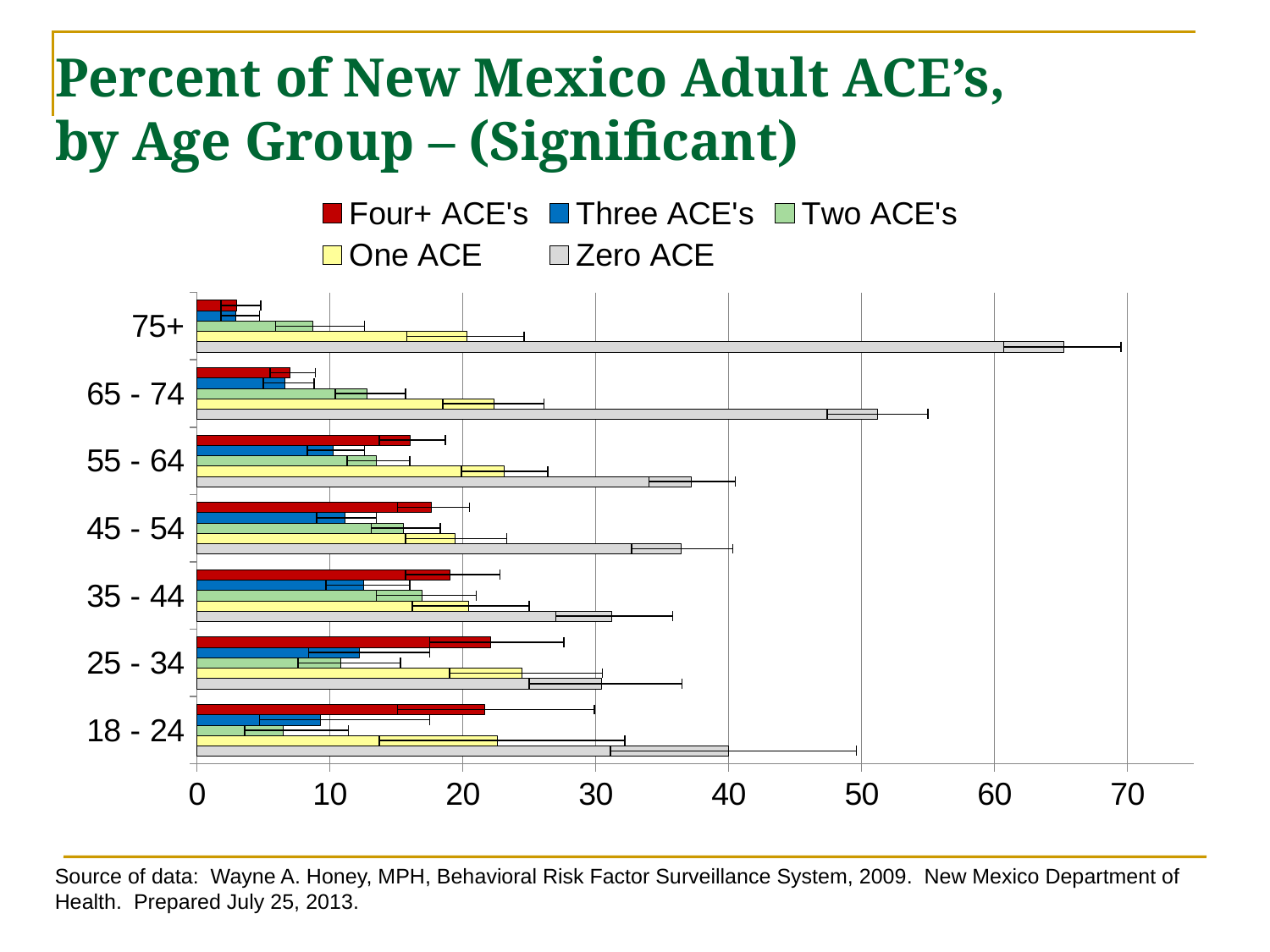
Which is larger, the Zero ACE value for 75+ or for 18 - 24? 75+ Is the Zero ACE value for the 65 - 74 age group greater or less than 50? greater Is the Zero ACE value for the 55 - 64 age group greater or less than 40? less What colour represents the Four+ ACE's series in the legend? red Which age group has the lowest Four+ ACE's value? 75+ How many series does the legend list? 5 What kind of chart is shown on the slide? bar chart Which age group has the highest Zero ACE value? 75+ Is the Four+ ACE's value for the 75+ age group greater or less than 10? less Which is larger, the Four+ ACE's value for 75+ or for 65 - 74? 65 - 74 How many age groups are shown on the chart? 7